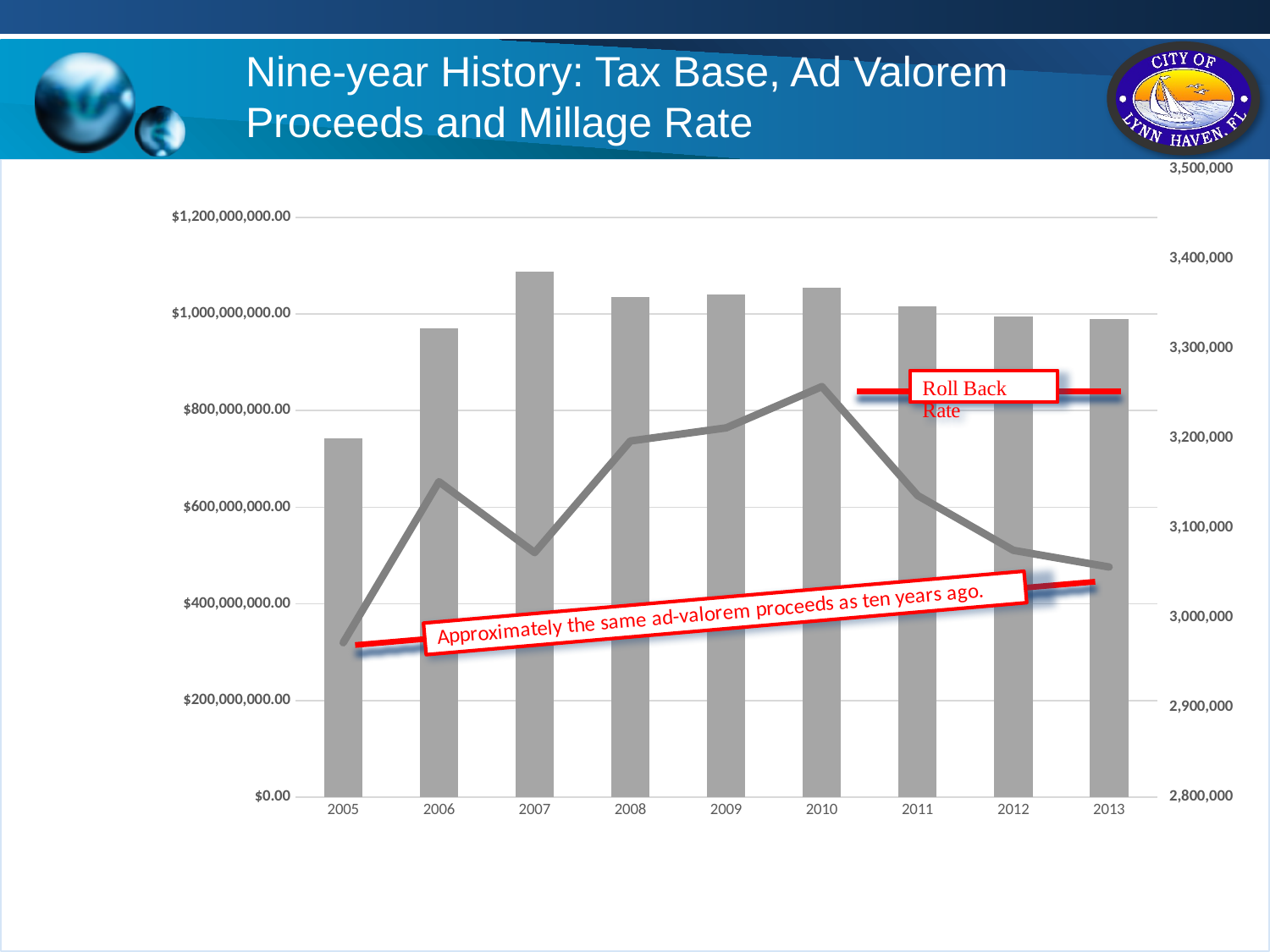
Is the bar value for 2007 greater or less than $1,000,000,000.00? greater In which year is the line series at its lowest point? 2005 Which year has the shortest bar in the chart? 2005 What kind of chart is shown on the slide? Bar chart with a line series Do the bar values rise or fall from 2010 to 2013? fall Is the bar value for 2006 greater or less than $1,000,000,000.00? less Which bar is taller, 2005 or 2006? 2006 Which year has the tallest bar in the chart? 2007 How many years are shown along the x axis of the chart? 9 What is the title of the slide containing the chart? Nine-year History: Tax Base, Ad Valorem Proceeds and Millage Rate Is the bar value for 2005 greater or less than $800,000,000.00? less In which year does the line series reach its highest point? 2010